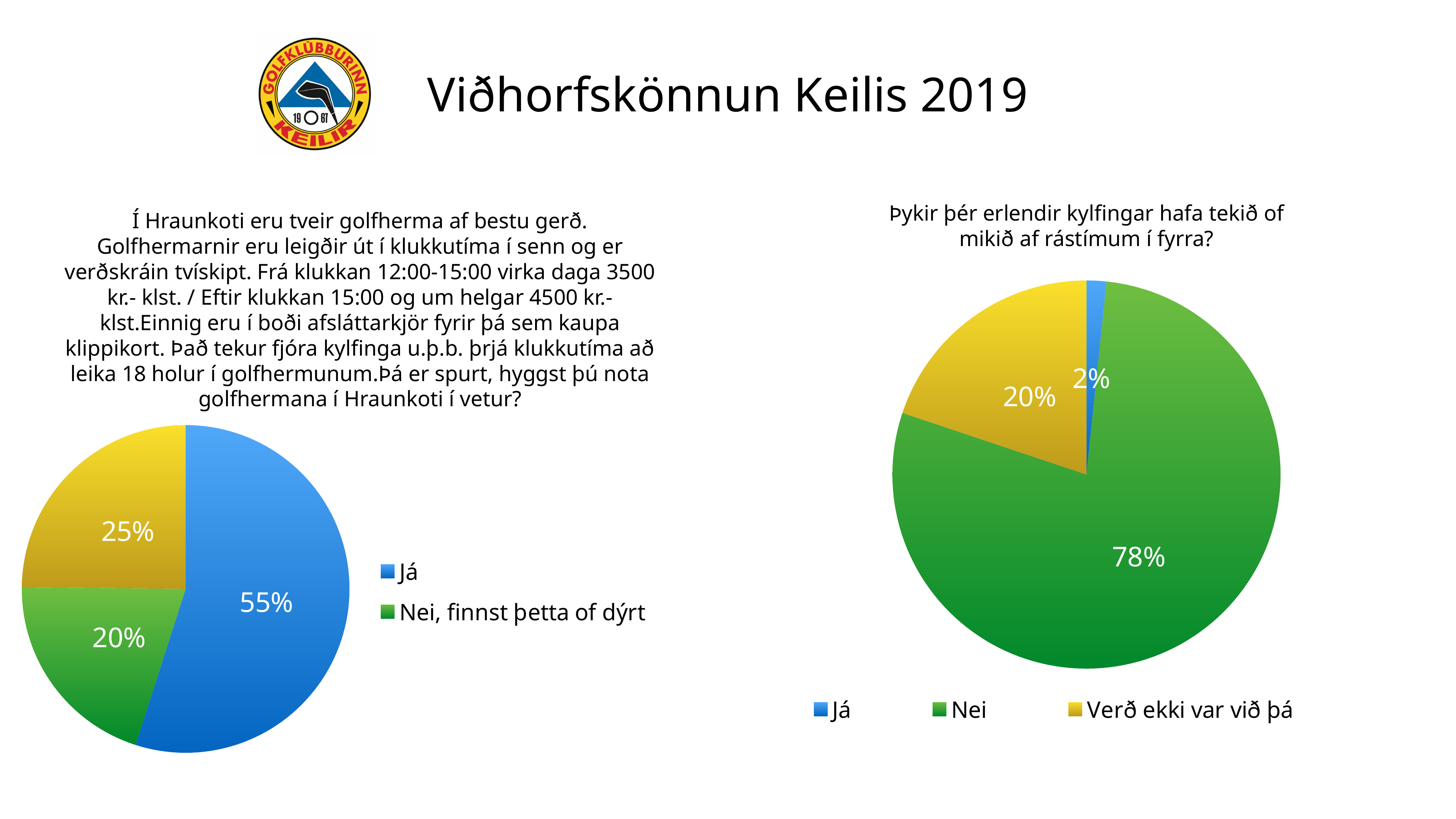
In the right pie chart "Þykir þér erlendir kylfingar hafa tekið of mikið af rástímum í fyrra?", which answer has the smallest slice? Já In the right pie chart "Þykir þér erlendir kylfingar hafa tekið of mikið af rástímum í fyrra?", what share of respondents answered "Já"? 2% In the left pie chart about the golf simulators in Hraunkot, what share of respondents answered "Já"? 55% What type of chart is used on the right side of the slide? Pie chart In the right pie chart "Þykir þér erlendir kylfingar hafa tekið of mikið af rástímum í fyrra?", what is the difference in percentage points between "Nei" and "Verð ekki var við þá"? 58 percentage points In the right pie chart "Þykir þér erlendir kylfingar hafa tekið of mikið af rástímum í fyrra?", what share of respondents answered "Nei"? 78% In the left pie chart about the golf simulators in Hraunkot, what percentage is shown on the yellow slice? 25% In the left pie chart about the golf simulators in Hraunkot, what share of respondents answered "Nei, finnst þetta of dýrt"? 20% In the left pie chart about the golf simulators in Hraunkot, which answer has the largest slice? Já In the right pie chart "Þykir þér erlendir kylfingar hafa tekið of mikið af rástímum í fyrra?", what share of respondents answered "Verð ekki var við þá"? 20% In the right pie chart "Þykir þér erlendir kylfingar hafa tekið of mikið af rástímum í fyrra?", how many entries does the legend list? 3 In the left pie chart about the golf simulators in Hraunkot, what is the difference in percentage points between the "Já" slice and the "Nei, finnst þetta of dýrt" slice? 35 percentage points